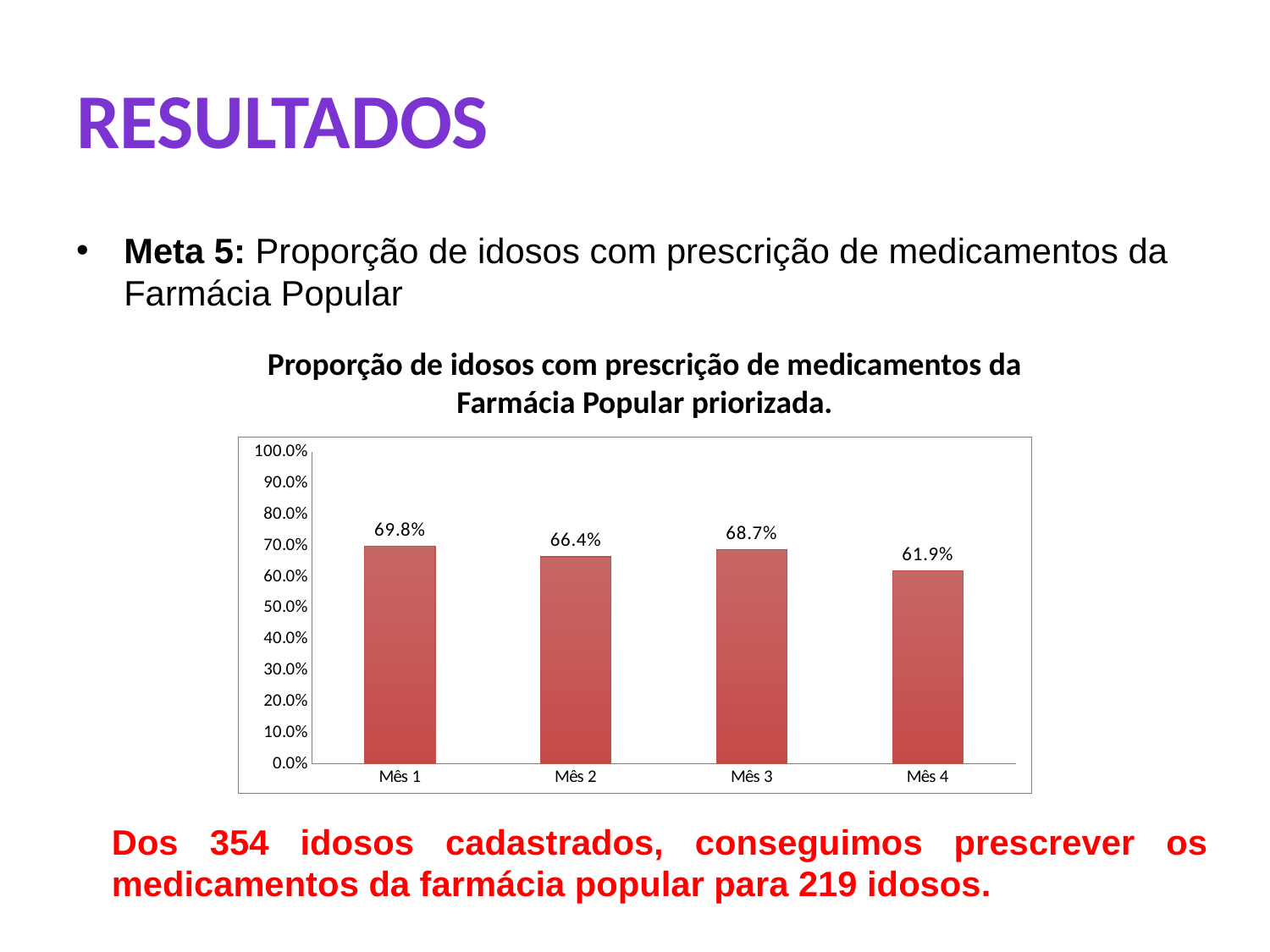
What is the value for Mês 1? 69.8% What is the value for Mês 4? 61.9% Which is larger, the value for Mês 2 or the value for Mês 3? Mês 3 What is the value for Mês 3? 68.7% Which month has the lowest value? Mês 4 What is the value for Mês 2? 66.4% How many months are shown on the x axis? 4 Which month has the highest value? Mês 1 Is the value for Mês 4 greater or less than 70.0%? less What is the title of the chart? Proporção de idosos com prescrição de medicamentos da Farmácia Popular priorizada. What is the difference between the values for Mês 1 and Mês 4? 7.9% What kind of chart is shown on the slide? bar chart